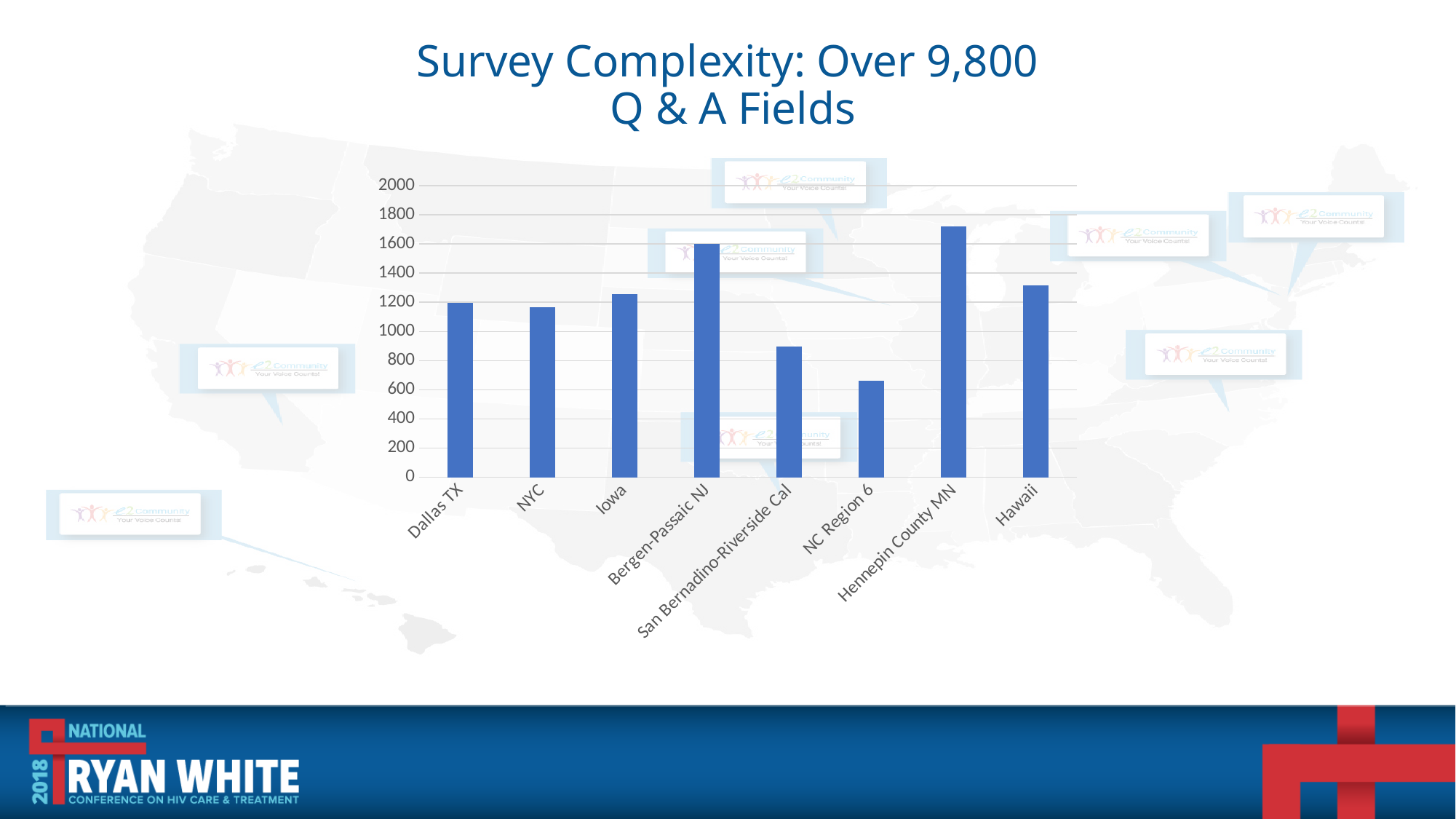
Is the value for Hennepin County MN greater or less than 1600? greater Is the value for San Bernadino-Riverside Cal greater or less than 1000? less Which category has the lowest bar in the chart? NC Region 6 Is the value for Dallas TX greater or less than 1400? less How many categories are plotted on the x axis of the chart? 8 Which is larger, the value for Hennepin County MN or the value for Bergen-Passaic NJ? Hennepin County MN What is the title of the slide containing the chart? Survey Complexity: Over 9,800 Q & A Fields Which category has the highest bar in the chart? Hennepin County MN What kind of chart is shown on the slide? bar chart Which is larger, the value for San Bernadino-Riverside Cal or the value for NC Region 6? San Bernadino-Riverside Cal